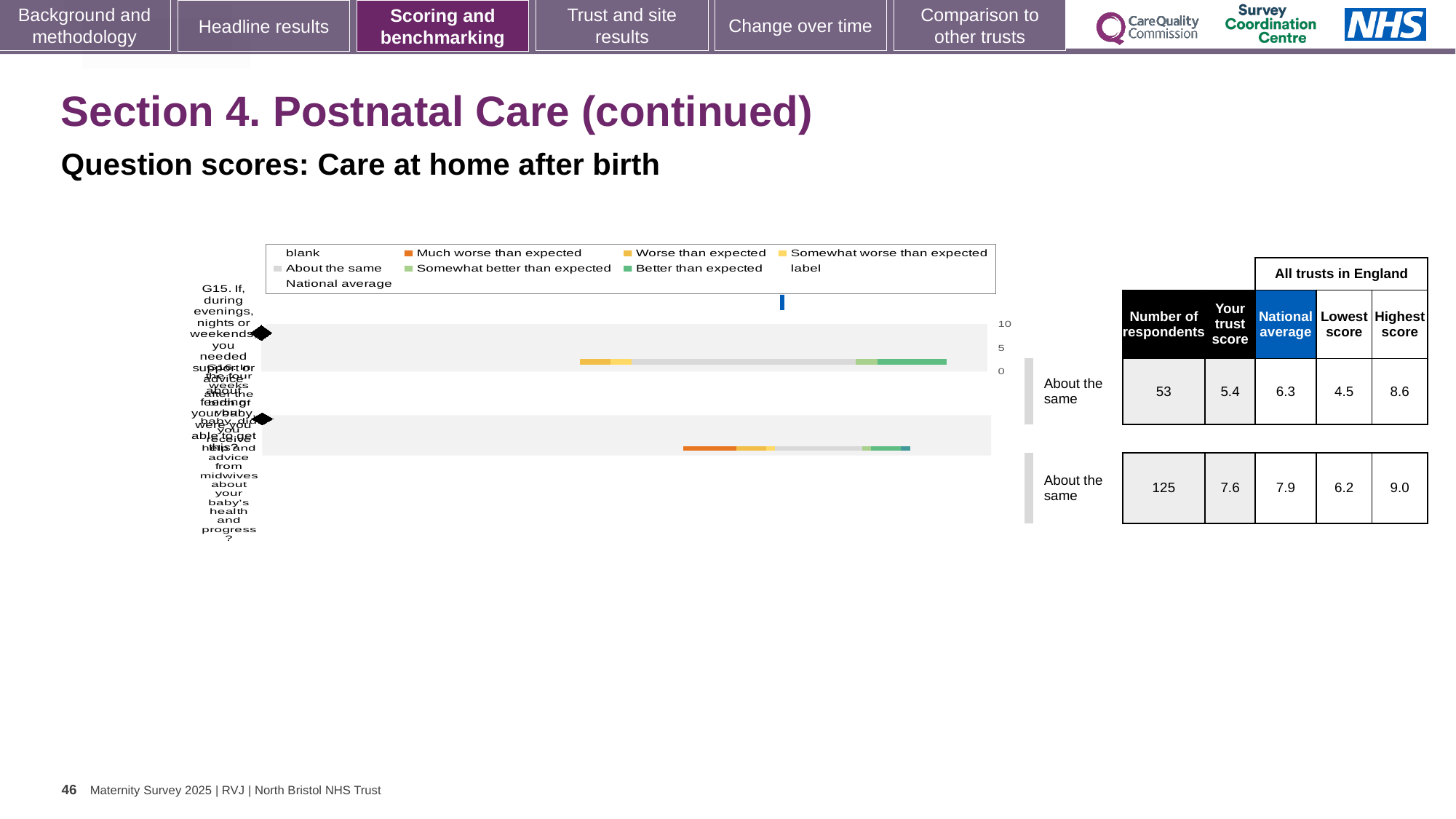
What is the 'Your trust score' for the question with 53 respondents? 5.4 What is the difference between the highest and lowest scores for the question with 53 respondents? 4.1 What is the lowest score among all trusts in England for the question with 125 respondents? 6.2 What is the national average for the question with 125 respondents? 7.9 What is the difference between the national average and the trust score for the question with 125 respondents? 0.3 What benchmark category is shown for both questions on the slide? About the same What is the subtitle describing the question scores shown on the slide? Question scores: Care at home after birth What is the highest score among all trusts in England for the question with 53 respondents? 8.6 How many question bars are plotted in the chart? 2 What kind of chart is shown on the slide? Bar chart In the chart legend, what does the blue marker represent? National average Which question has the higher trust score: the one with 53 respondents or the one with 125 respondents? The one with 125 respondents